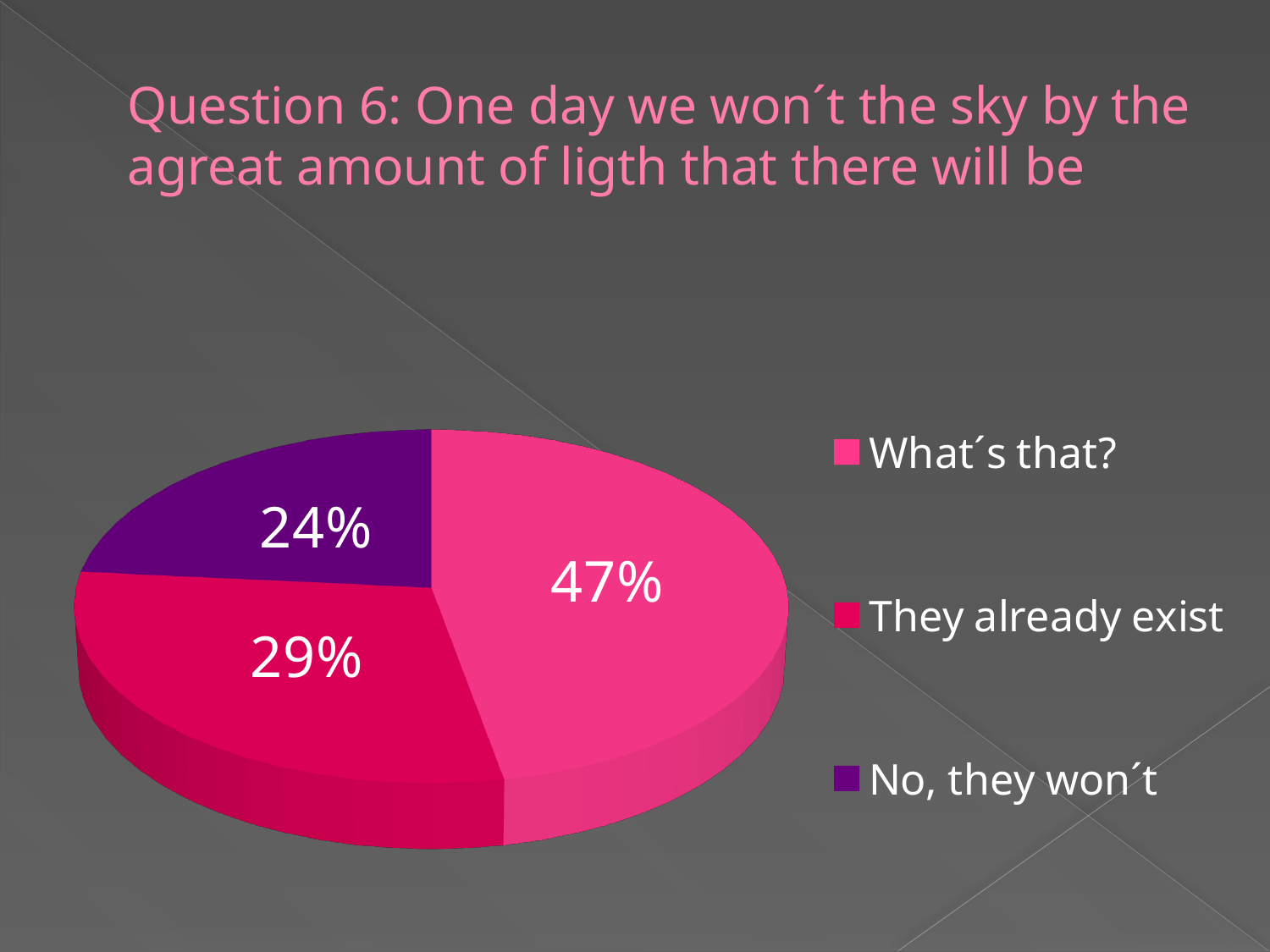
What is the difference in percentage points between the "They already exist" slice and the "No, they won´t" slice? 5 What kind of chart is shown on the slide? pie chart What colour is the "No, they won´t" slice? purple How many slices does the pie chart have? 3 Which category has the largest share of the pie? What´s that? What percentage of the pie is the "What´s that?" slice? 47% Which category has the smallest share of the pie? No, they won´t What is the difference in percentage points between the "What´s that?" slice and the "They already exist" slice? 18 How many entries does the legend list? 3 Which is larger, the "They already exist" slice or the "No, they won´t" slice? They already exist What percentage of the pie is the "They already exist" slice? 29% What percentage of the pie is the "No, they won´t" slice? 24%